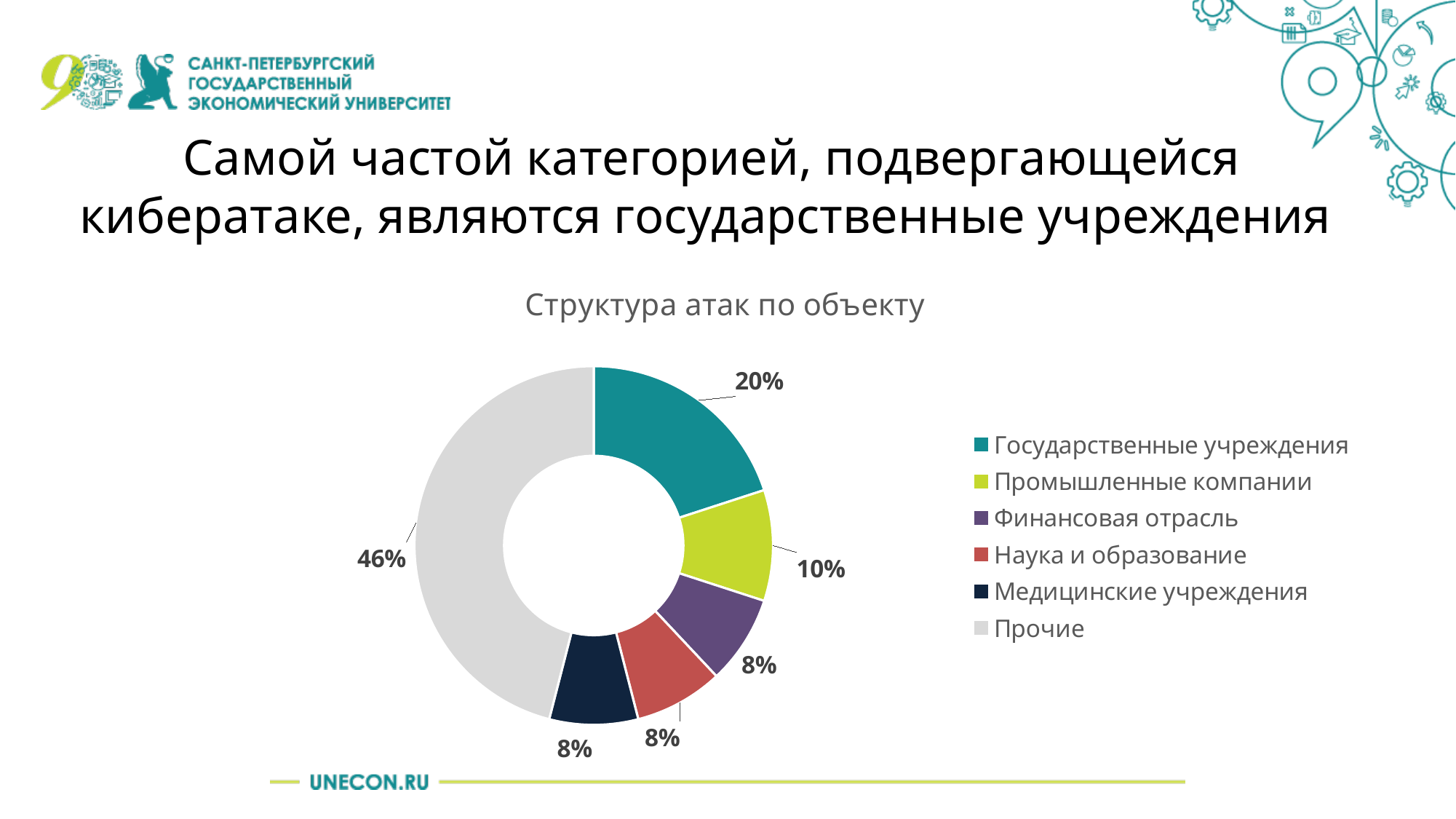
What percentage does the Промышленные компании slice show? 10% How many categories are shown in the chart? 6 Which category has the largest slice in the chart? Прочие By how many percentage points does Прочие exceed Государственные учреждения? 26% What share of attacks is attributed to Государственные учреждения in the chart? 20% Which legend entry is shown in grey? Прочие Which is larger: the share for Государственные учреждения or for Промышленные компании? Государственные учреждения What is the title of the chart? Структура атак по объекту What is the difference between the shares of Государственные учреждения and Финансовая отрасль? 12% What type of chart is shown on the slide? Pie (doughnut) chart What is the value shown for Прочие? 46% What share is shown for Медицинские учреждения? 8%